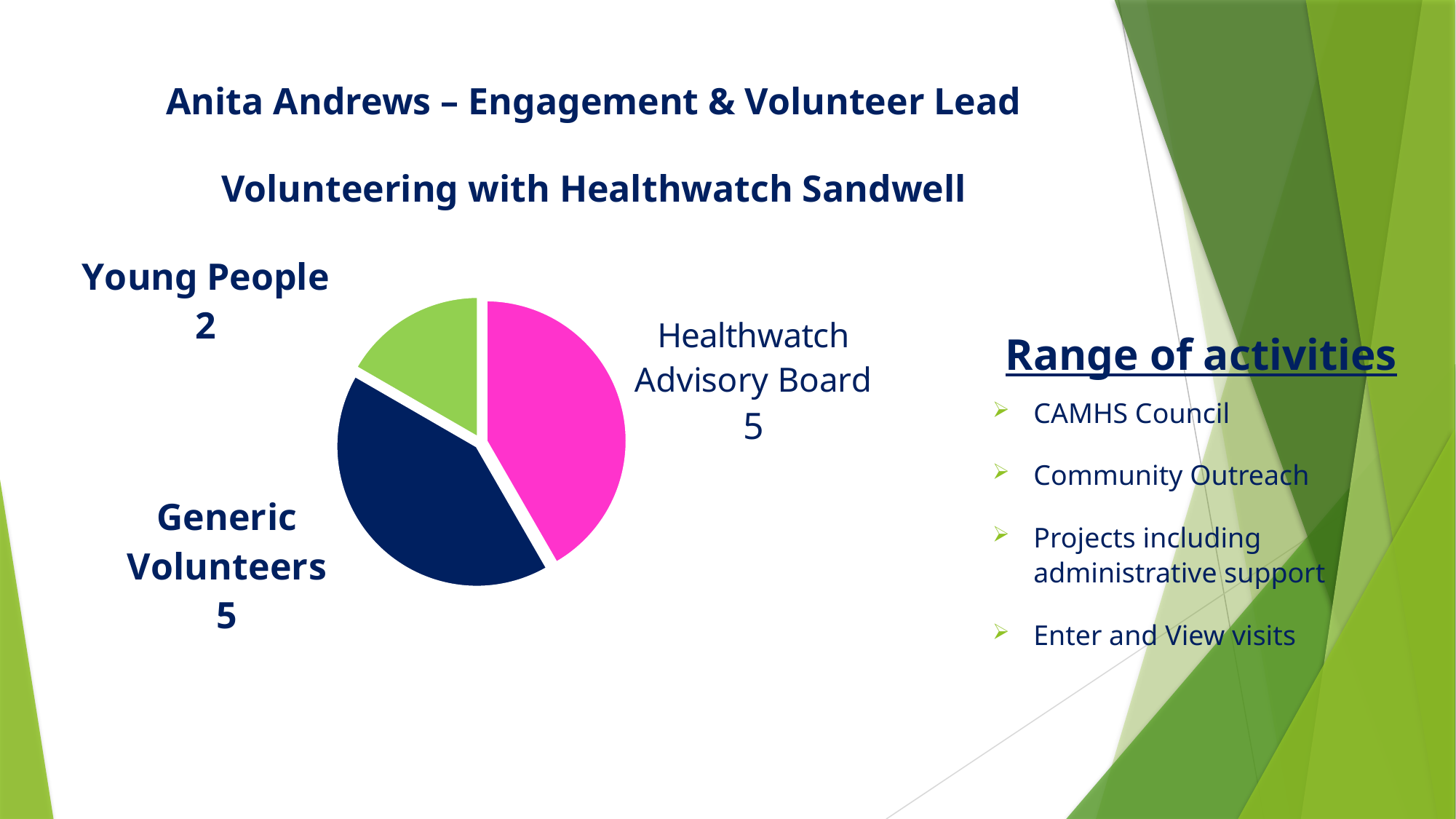
Which category has the smallest slice in the pie chart? Young People What is the value for Healthwatch Advisory Board in the pie chart? 5 What kind of chart is shown on the slide? pie chart What fraction of the total does the Young People slice represent? 2/12 What colour is the Healthwatch Advisory Board slice in the pie chart? pink What colour is the Generic Volunteers slice in the pie chart? dark navy blue What is the difference between the values for Healthwatch Advisory Board and Young People? 3 What is the total of all the values shown in the pie chart? 12 How many slices does the pie chart have? 3 Which is larger in the pie chart, Generic Volunteers or Young People? Generic Volunteers What is the value for Generic Volunteers in the pie chart? 5 What is the value for Young People in the pie chart? 2